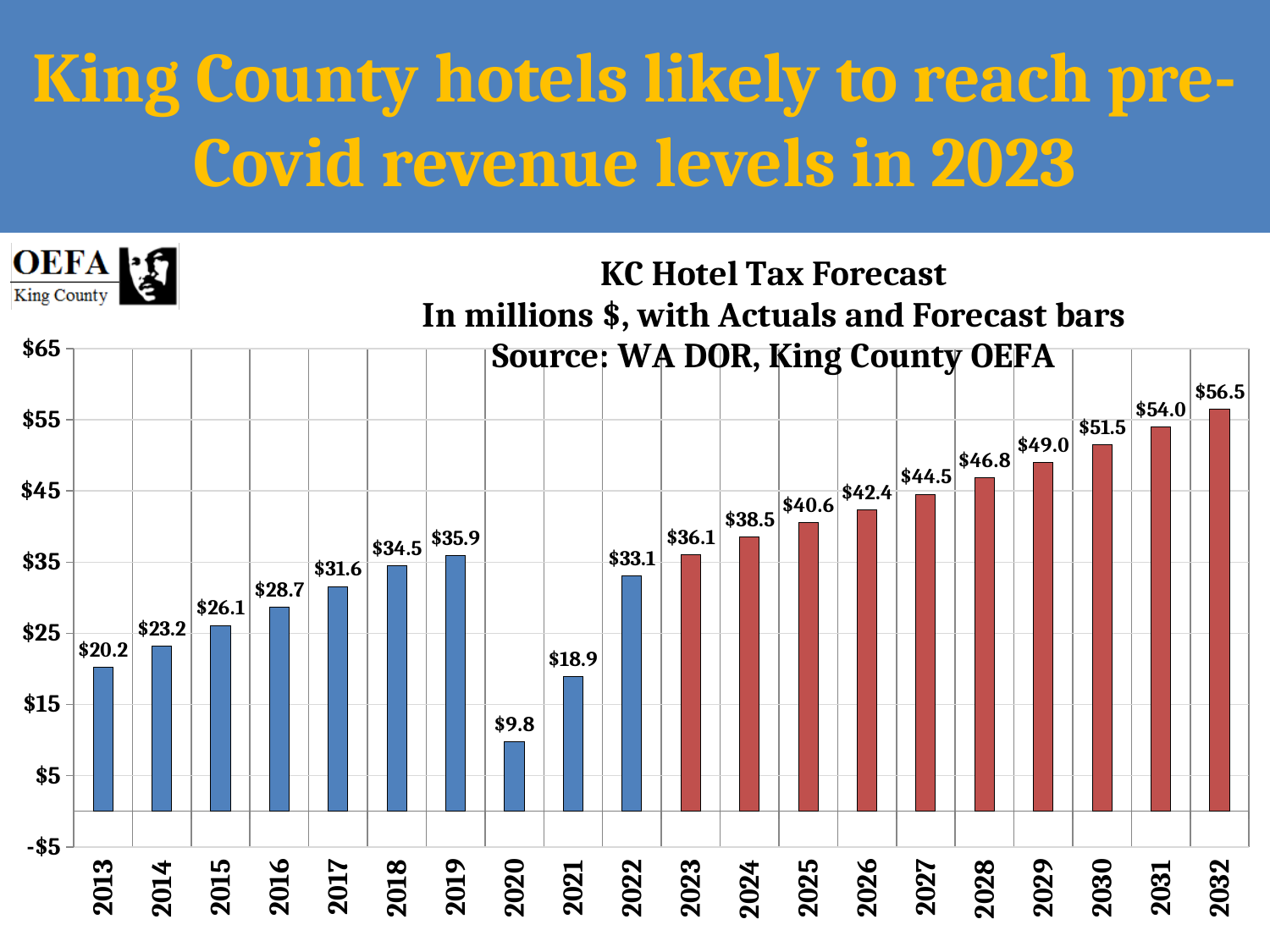
What is the value for 2032? $56.5 What is the value for 2020? $9.8 Which year has the lowest value? 2020 What is the value for 2019? $35.9 Which year has the highest value? 2032 What is the title of the chart? KC Hotel Tax Forecast How many years are shown on the x axis? 20 Which is larger, the value for 2018 or the value for 2022? 2018 Is the value for 2030 greater or less than $45? greater What is the difference between the values for 2022 and 2021? $14.2 What kind of chart is this? bar chart What is the difference between the values for 2023 and 2019? $0.2